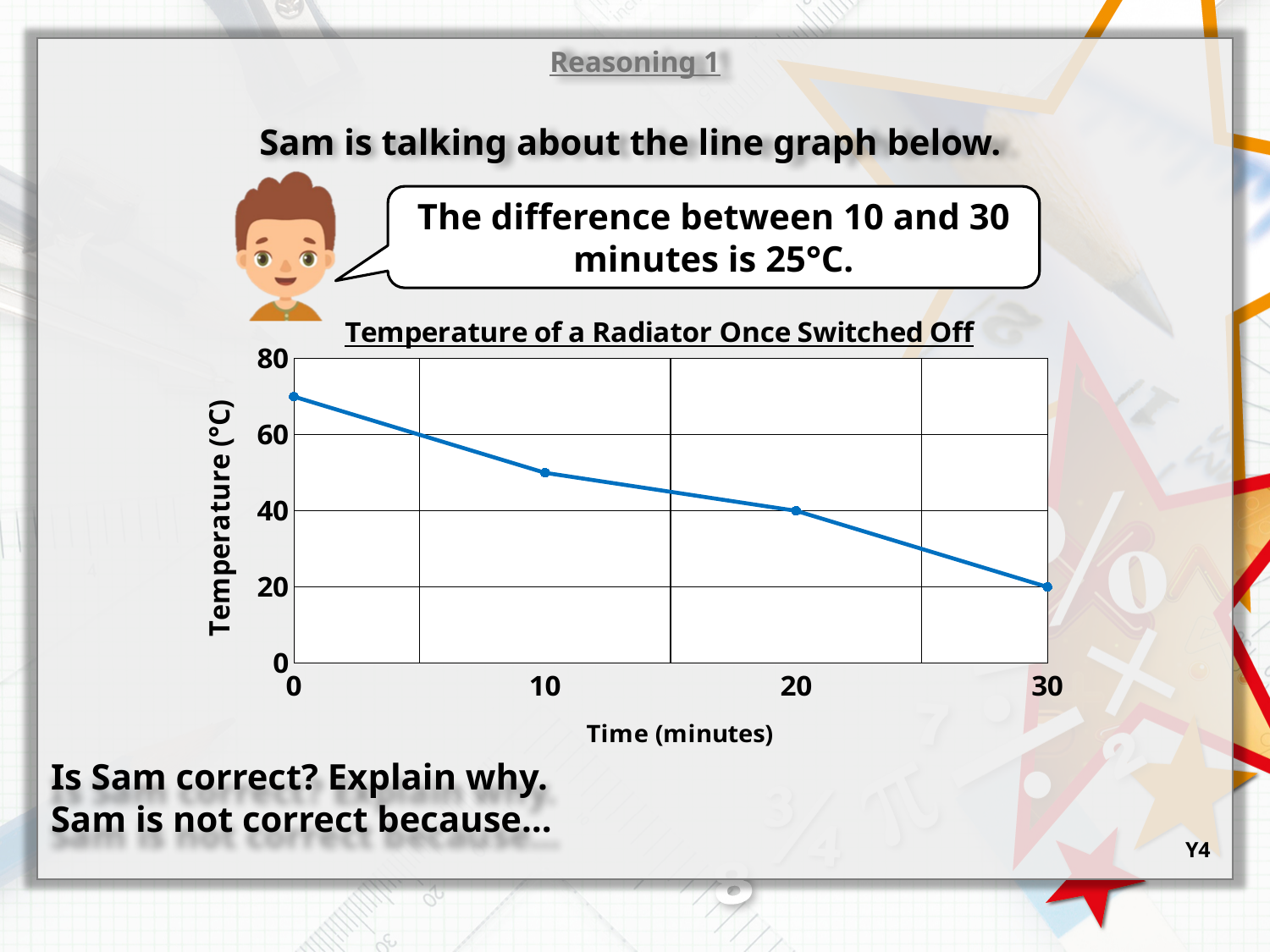
What is the difference between the temperature at 20 minutes and at 30 minutes? 20 At which time is the temperature highest? 0 minutes What kind of chart is shown on the slide? line chart What is the temperature of the radiator at 20 minutes? 40 How many data points are plotted on the line graph? 4 What is the title of the line graph? Temperature of a Radiator Once Switched Off At which time is the temperature lowest? 30 minutes Does the temperature rise or fall as time increases along the x axis? fall What is the temperature of the radiator at 30 minutes? 20 Is the temperature at 10 minutes greater or less than 60? less Which is larger, the temperature at 10 minutes or at 20 minutes? 10 minutes Is the temperature at 0 minutes greater or less than 60? greater